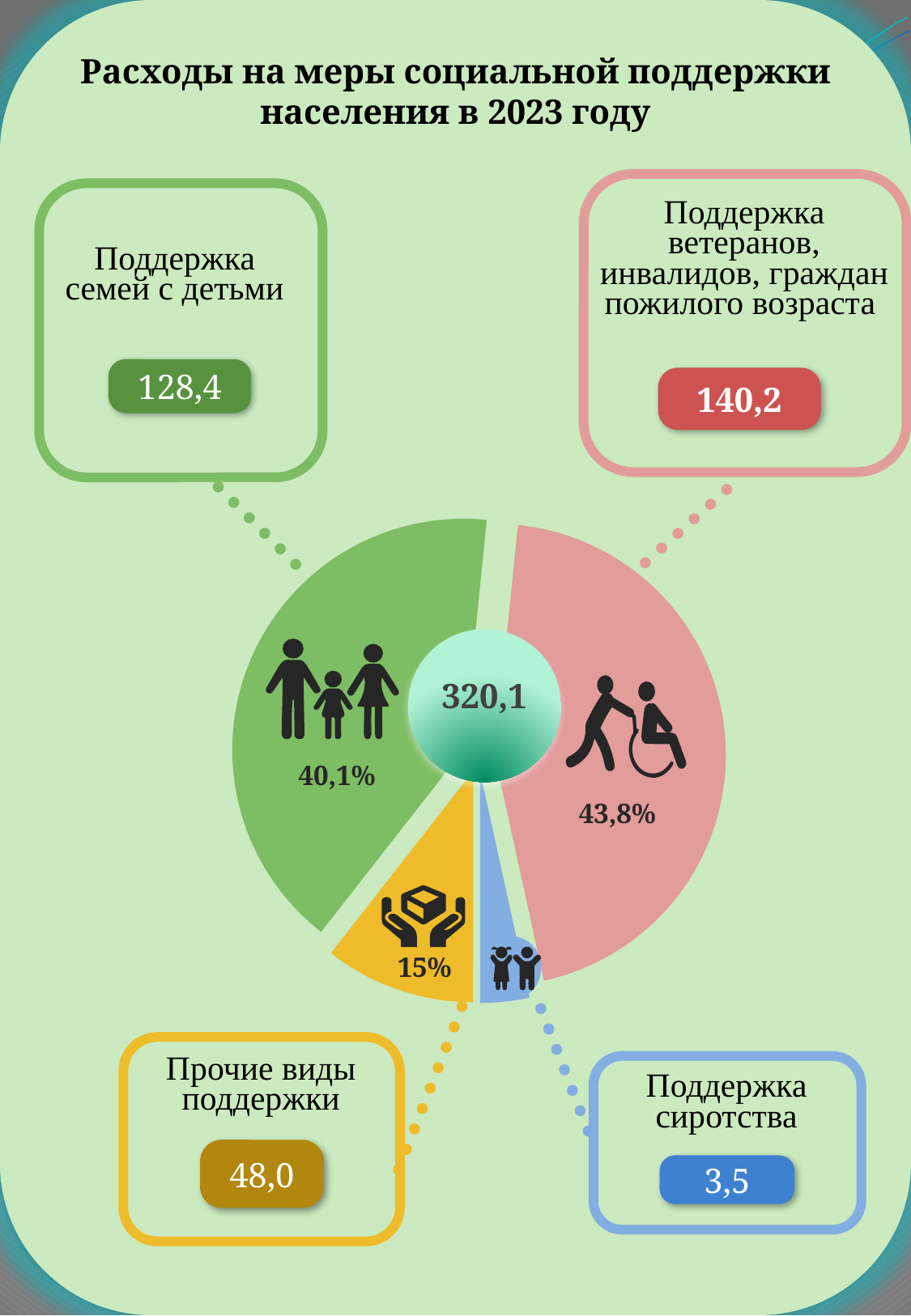
What type of chart is shown on the slide? pie chart What share of the pie does «Поддержка семей с детьми» represent? 40,1% What is the value for «Поддержка семей с детьми»? 128,4 What is the difference between the values for «Поддержка ветеранов, инвалидов, граждан пожилого возраста» and «Поддержка семей с детьми»? 11,8 What is the value for «Прочие виды поддержки»? 48,0 Which category has the smallest slice of the pie? Поддержка сиротства What share of the pie does «Прочие виды поддержки» represent? 15% What total is shown in the centre of the pie chart? 320,1 What is the value for «Поддержка сиротства»? 3,5 How many categories does the pie chart have? 4 Which category has the largest slice of the pie? Поддержка ветеранов, инвалидов, граждан пожилого возраста What is the value for «Поддержка ветеранов, инвалидов, граждан пожилого возраста»? 140,2